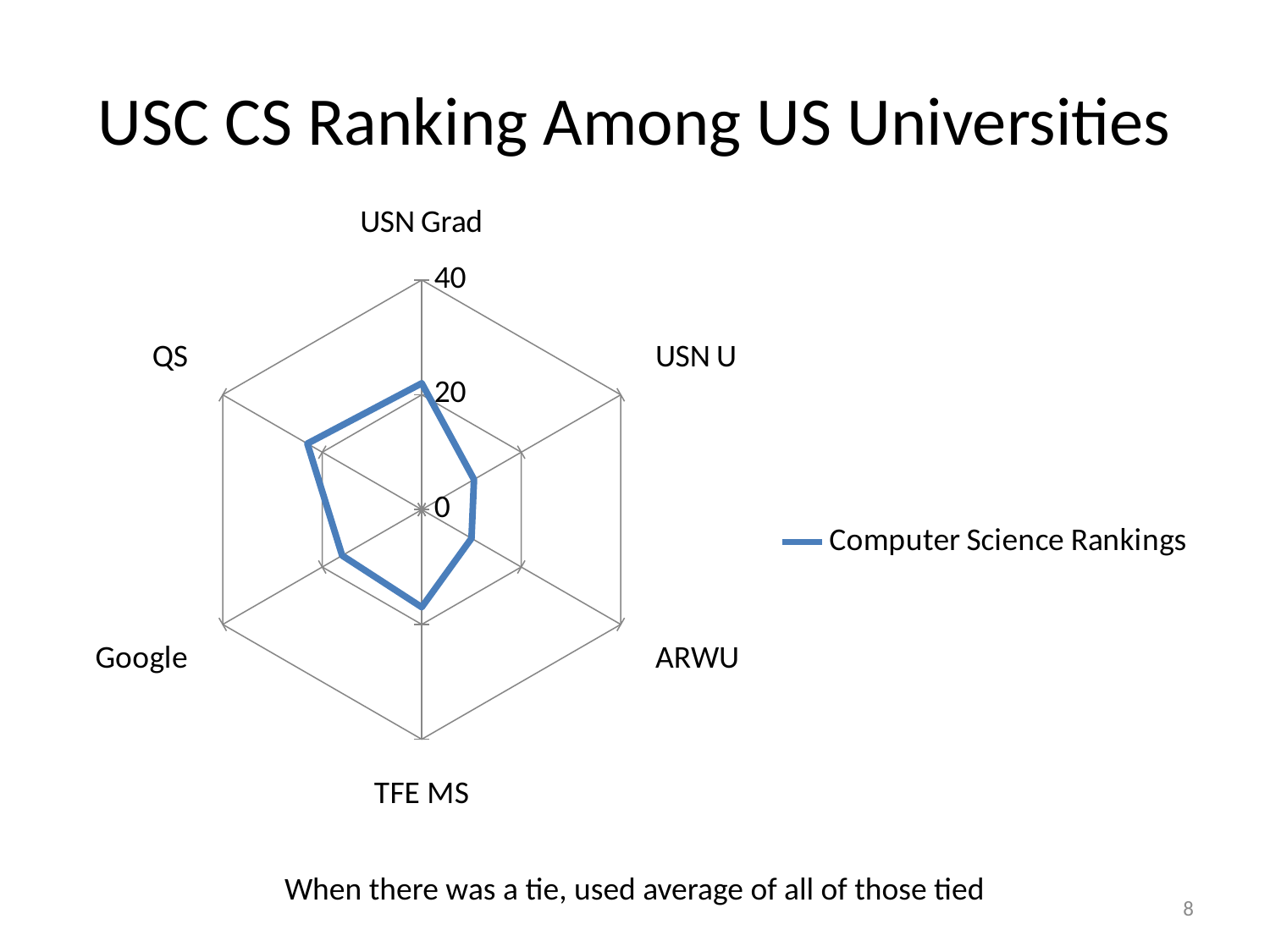
How many series does the legend list? 1 Is the value for USN Grad greater or less than 40? less How many ranking categories (axes) does the radar chart have? 6 Which has the larger value, USN Grad or ARWU? USN Grad Is the value for TFE MS greater or less than 20? less Is the value for QS greater or less than 20? greater What is the title of the chart on the slide? USC CS Ranking Among US Universities Which has the larger value, QS or USN U? QS What kind of chart is shown on the slide? Radar chart What is the name of the series shown in the legend? Computer Science Rankings